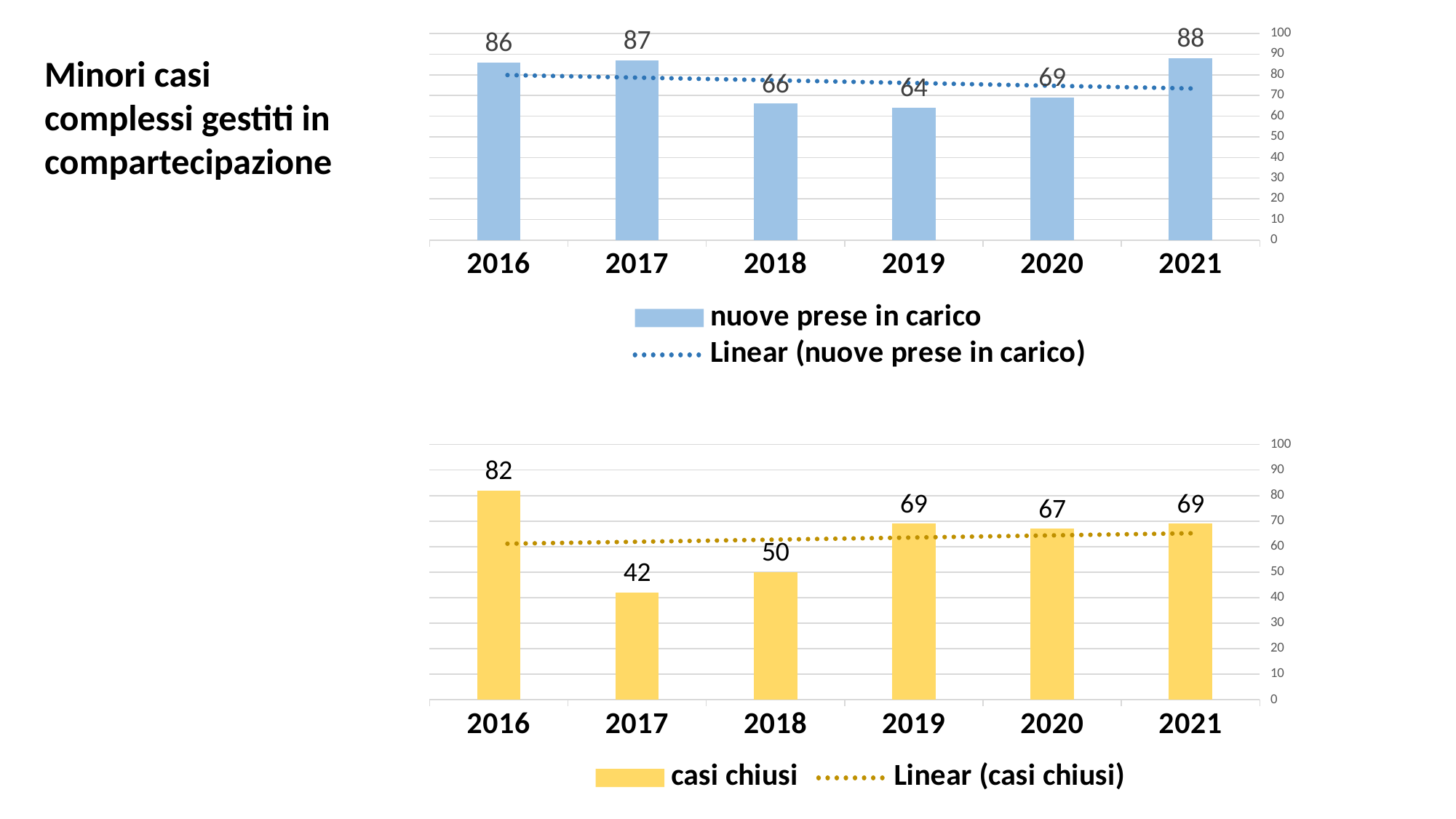
In the top chart (nuove prese in carico), what is the difference between the values for 2021 and 2019? 24 In the top chart (nuove prese in carico), which year has the highest value? 2021 In the bottom chart (casi chiusi), which is larger, the value for 2019 or the value for 2020? 2019 How many entries does the legend of the top chart list? 2 In the bottom chart (casi chiusi), which year has the highest value? 2016 What kind of chart is the bottom chart (casi chiusi)? Bar chart In the bottom chart (casi chiusi), what is the difference between the values for 2016 and 2018? 32 In the top chart (nuove prese in carico), what is the value for 2018? 66 In the top chart (nuove prese in carico), which year has the lowest value? 2019 In the bottom chart (casi chiusi), which year has the lowest value? 2017 In the top chart (nuove prese in carico), how many years are shown on the x axis? 6 In the bottom chart (casi chiusi), what is the value for 2017? 42